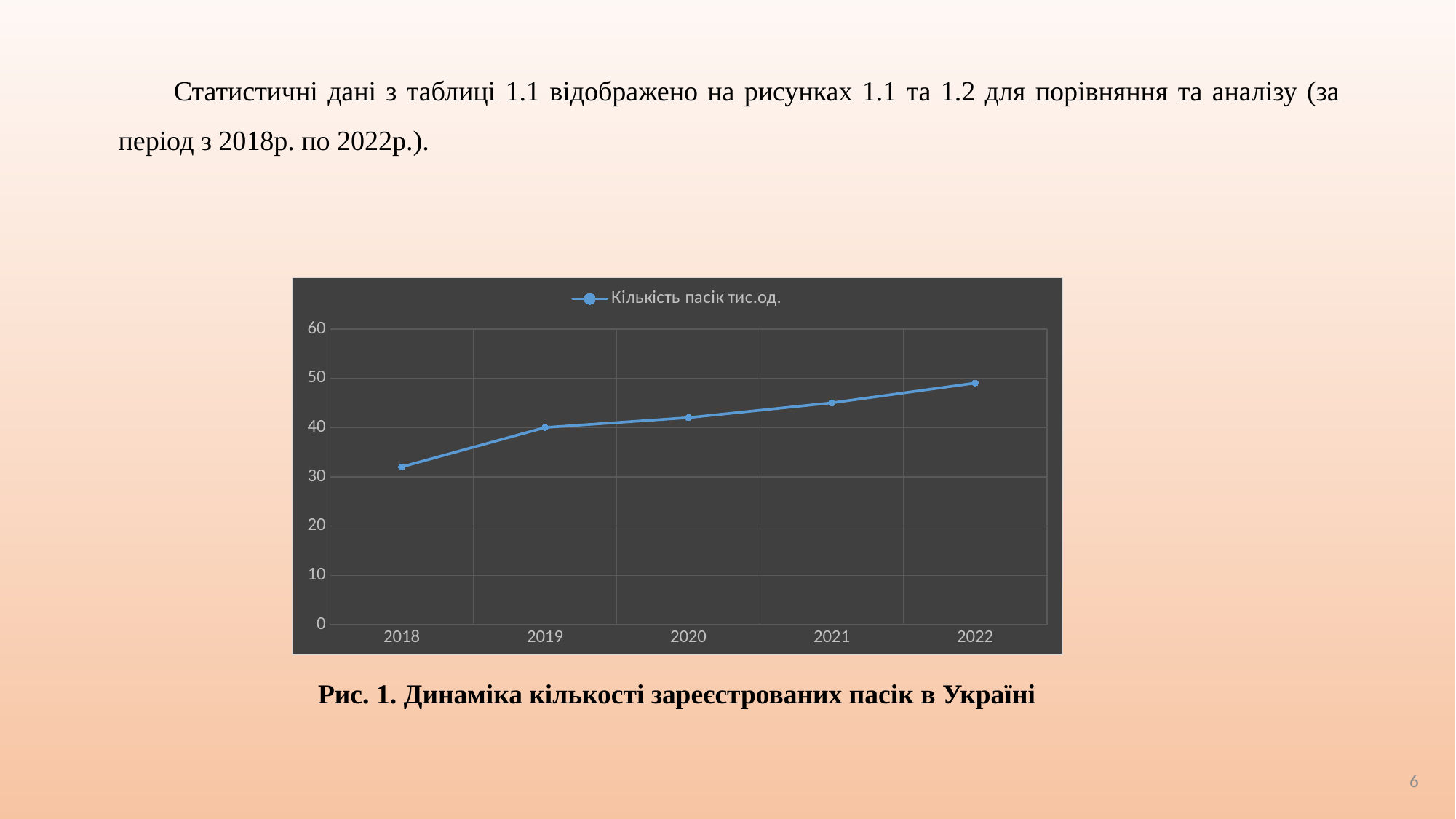
How many years are plotted on the x axis of the chart? 5 Is the value for 2022 greater or less than 40? greater Which year has the larger value, 2019 or 2022? 2022 Do the values for Кількість пасік тис.од. rise or fall from 2018 to 2022? rise Which year has the highest value for Кількість пасік тис.од.? 2022 Is the value for 2018 greater or less than 30? greater Is the value for 2021 greater or less than 40? greater Which year has the lowest value for Кількість пасік тис.од.? 2018 What kind of chart is shown on the slide? line chart What is the name of the series shown in the chart legend? Кількість пасік тис.од. How many series does the chart legend list? 1